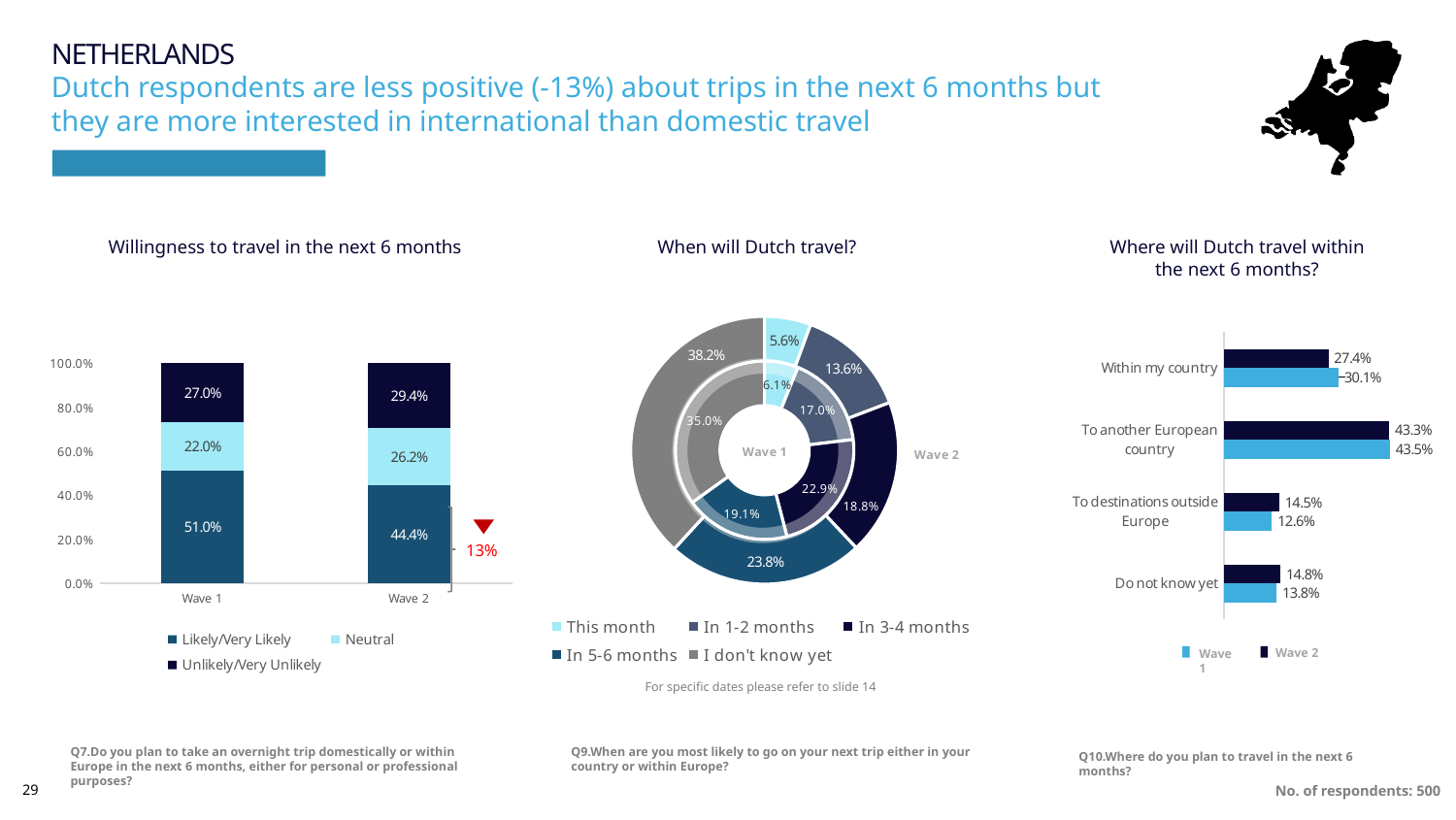
In the 'Where will Dutch travel within the next 6 months?' chart, which destination has the highest Wave 2 value? To another European country What kind of chart is 'Where will Dutch travel within the next 6 months?' Bar chart In the 'Willingness to travel in the next 6 months' chart, what is the difference between the Likely/Very Likely values for Wave 1 and Wave 2? 6.6% In the 'When will Dutch travel?' chart, how many categories does the legend list? 5 In the 'When will Dutch travel?' chart, which category has the smallest Wave 2 share? This month In the 'When will Dutch travel?' chart, what is the Wave 2 share for 'I don't know yet'? 38.2% In the 'Where will Dutch travel within the next 6 months?' chart, which is larger for 'To destinations outside Europe': Wave 1 or Wave 2? Wave 2 In the 'Willingness to travel in the next 6 months' chart, how many series does the legend list? 3 In the 'Willingness to travel in the next 6 months' chart, what is the Neutral value for Wave 1? 22.0% In the 'Willingness to travel in the next 6 months' chart, what is the Likely/Very Likely value for Wave 2? 44.4% What kind of chart is 'When will Dutch travel?' Doughnut chart In the 'Where will Dutch travel within the next 6 months?' chart, what is the Wave 1 value for 'Within my country'? 30.1%